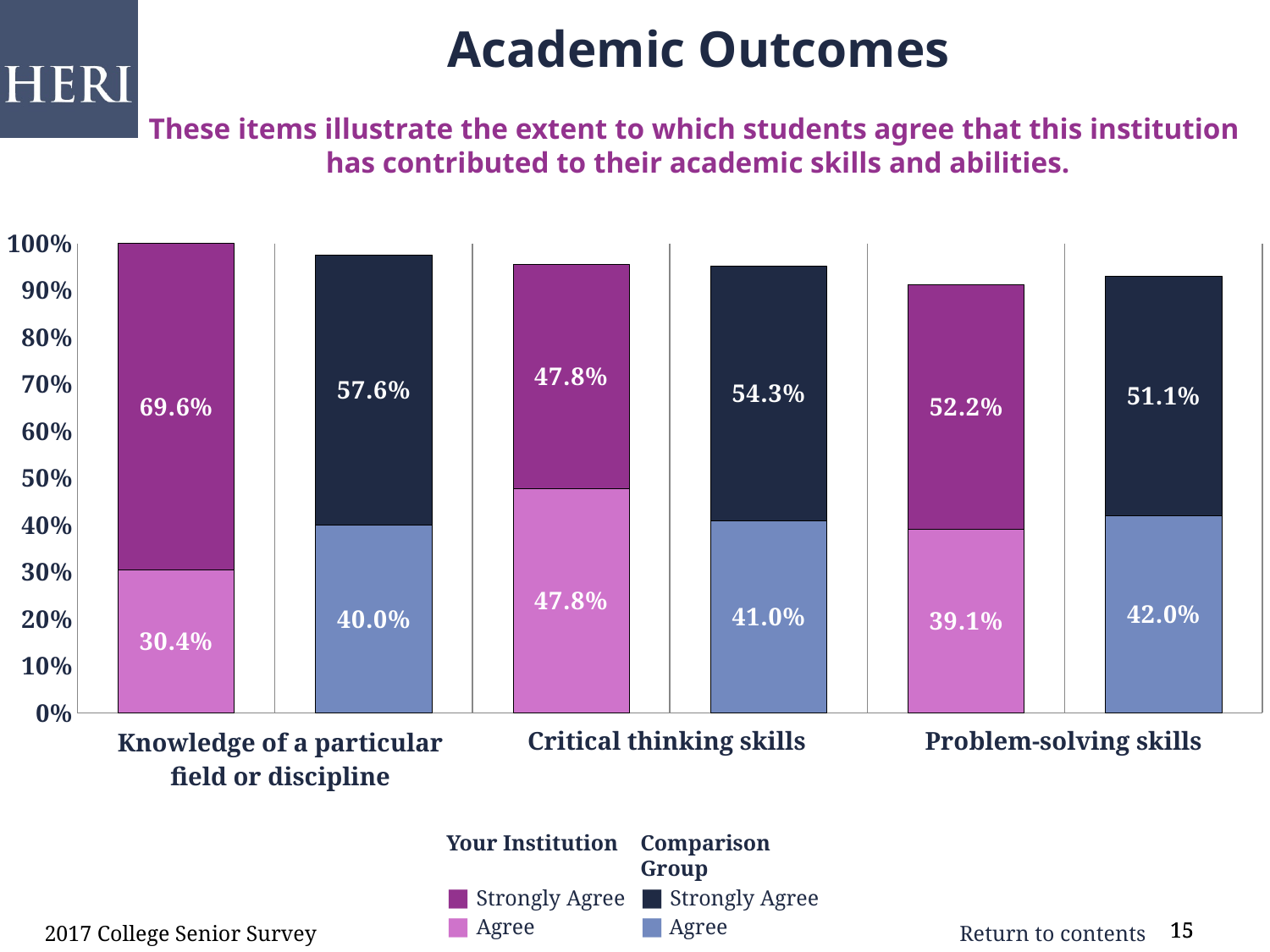
What is the combined Agree plus Strongly Agree total for the Comparison Group bar for Knowledge of a particular field or discipline? 97.6% What type of chart is shown on the slide? Stacked bar chart Across the three categories, which has the highest Your Institution Strongly Agree value? Knowledge of a particular field or discipline What is the combined Agree plus Strongly Agree total for the Your Institution bar for Problem-solving skills? 91.3% For Critical thinking skills, which is larger: the Your Institution Strongly Agree value or the Comparison Group Strongly Agree value? Comparison Group Strongly Agree What is the Your Institution Agree value for Problem-solving skills? 39.1% What is the difference between the Your Institution and Comparison Group Strongly Agree values for Knowledge of a particular field or discipline? 12.0% What percentage of Your Institution students Strongly Agree that the institution contributed to their knowledge of a particular field or discipline? 69.6% What is the Comparison Group's Strongly Agree value for Problem-solving skills? 51.1% Which category has the lowest Your Institution Agree value? Knowledge of a particular field or discipline What is the Comparison Group's Agree value for Critical thinking skills? 41.0% How many categories are shown on the x axis of the chart? 3